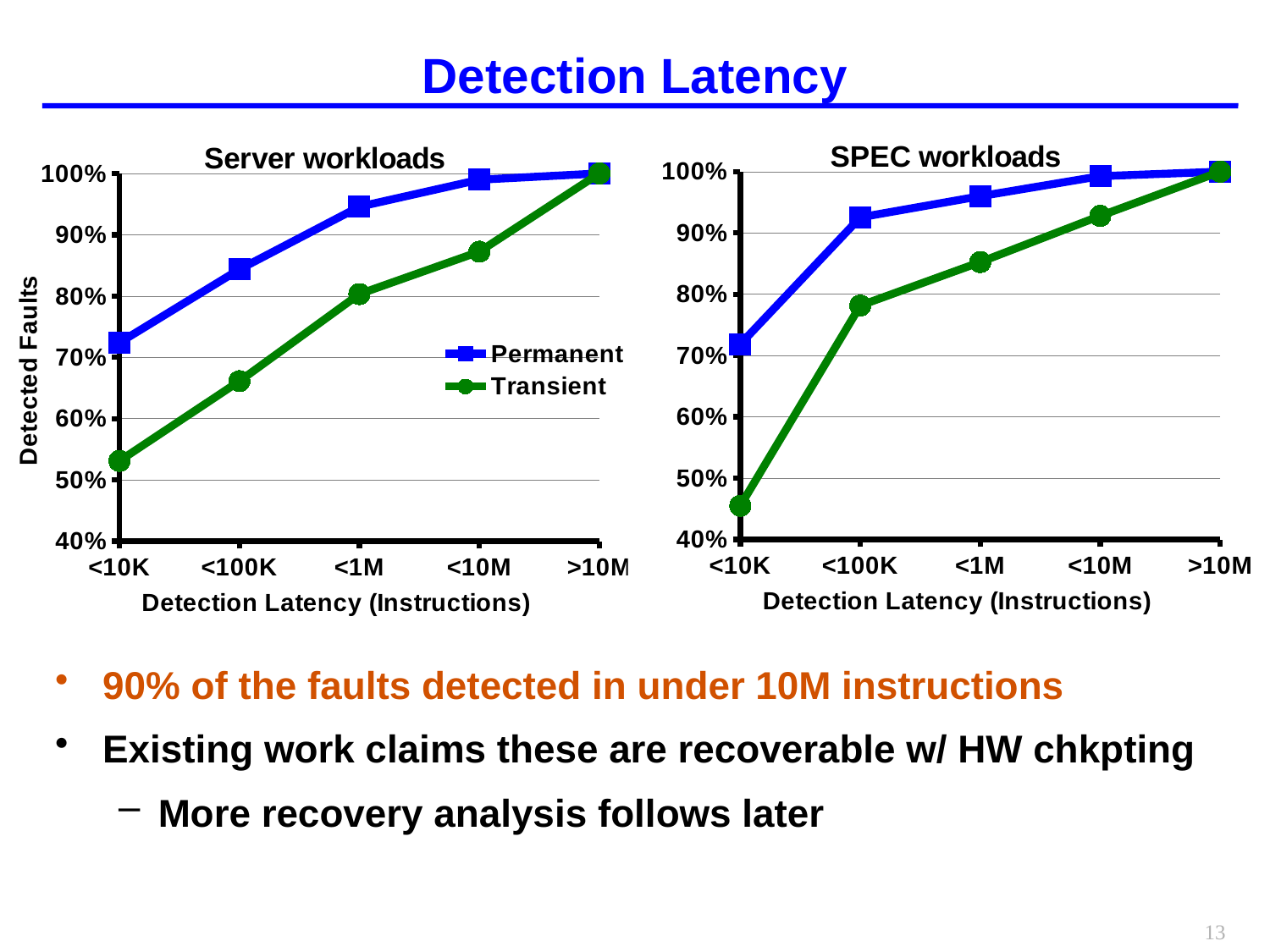
In the SPEC workloads chart, at which detection latency category is the Transient series lowest? <10K How many series does the legend of the Server workloads chart list? 2 In the Server workloads chart, do the Transient values rise or fall from <10K to >10M? rise What is the y-axis label of the Server workloads chart? Detected Faults In the SPEC workloads chart, is the Permanent value at <100K greater or less than 90%? greater How many detection latency categories are shown on the x axis of the SPEC workloads chart? 5 What kind of chart is the Server workloads chart? line chart In the SPEC workloads chart, is the Transient value at <10K greater or less than 50%? less In the SPEC workloads chart, what is the Transient value at >10M? 100% In the Server workloads chart, is the Transient value at <10K greater or less than 60%? less In the Server workloads chart, which series has the higher value at <100K, Permanent or Transient? Permanent